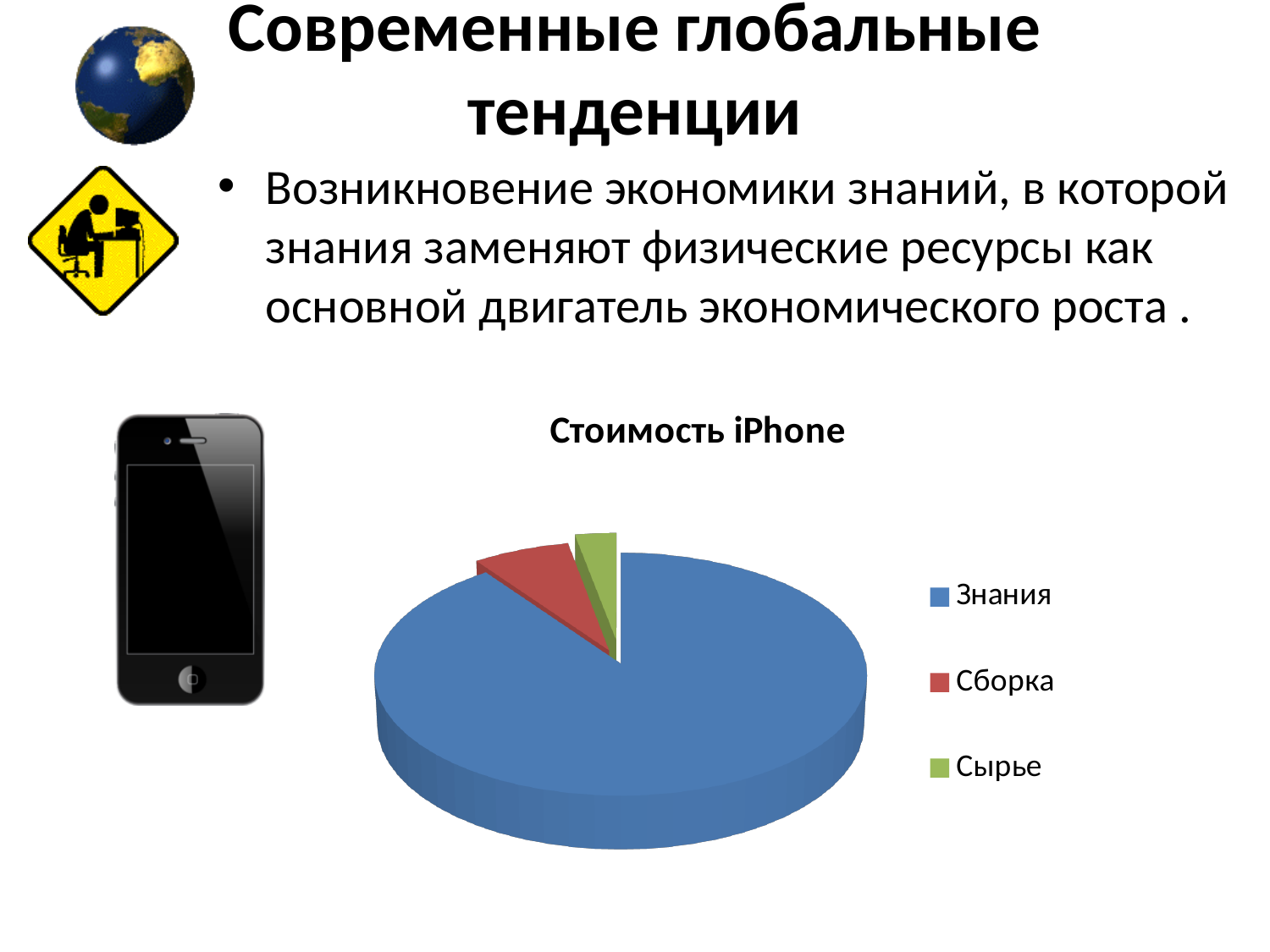
Which category has the largest slice in the "Стоимость iPhone" pie chart? Знания What kind of chart is shown under the title "Стоимость iPhone"? pie chart Which colour represents Знания in the "Стоимость iPhone" pie chart? blue What is the title of the chart on the slide? Стоимость iPhone How many slices does the pie chart "Стоимость iPhone" have? 3 Does the Знания slice take up more or less than half of the "Стоимость iPhone" pie? more Which category has the smallest slice in the "Стоимость iPhone" pie chart? Сырье In the "Стоимость iPhone" pie chart, which slice is larger: Знания or Сборка? Знания In the "Стоимость iPhone" pie chart, which slice is larger: Сборка or Сырье? Сборка How many entries does the legend of the "Стоимость iPhone" chart list? 3